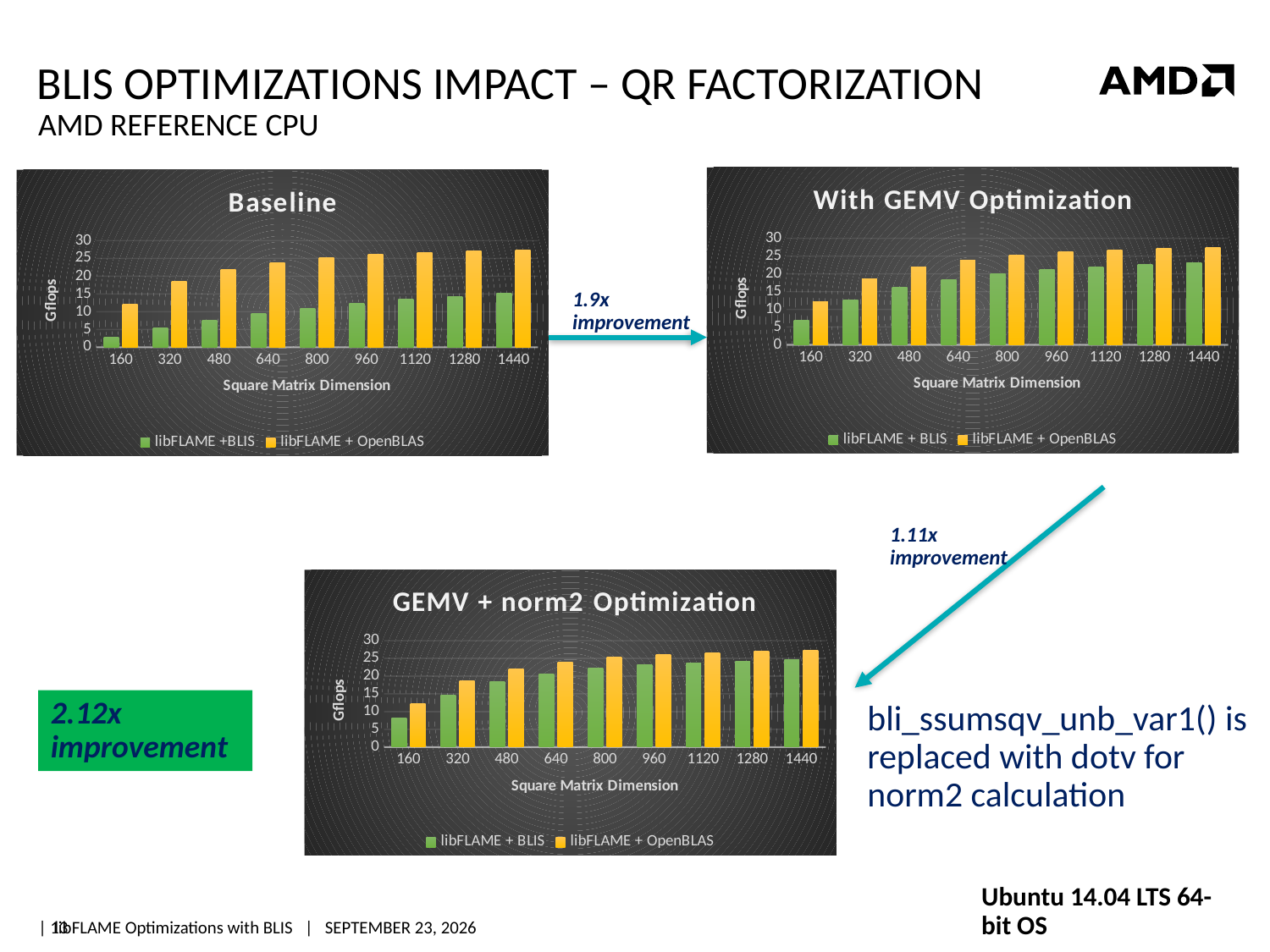
How many square matrix dimension categories are shown on the x axis of the With GEMV Optimization chart? 9 What type of chart is the Baseline chart? bar chart In the Baseline chart, at which square matrix dimension is the libFLAME +BLIS value lowest? 160 In the GEMV + norm2 Optimization chart, do the libFLAME + BLIS values rise or fall as the square matrix dimension increases? rise In the GEMV + norm2 Optimization chart, is the libFLAME + BLIS value at dimension 160 greater or less than 5? greater In the Baseline chart, is the libFLAME +BLIS value at dimension 160 greater or less than 5? less In the Baseline chart, is the libFLAME + OpenBLAS value at dimension 1440 greater or less than 25? greater In the Baseline chart, which series has the larger value at dimension 160, libFLAME +BLIS or libFLAME + OpenBLAS? libFLAME + OpenBLAS What is the title of the chart at the bottom of the slide? GEMV + norm2 Optimization What is the y-axis label on the With GEMV Optimization chart? Gflops How many series does the legend of the Baseline chart list? 2